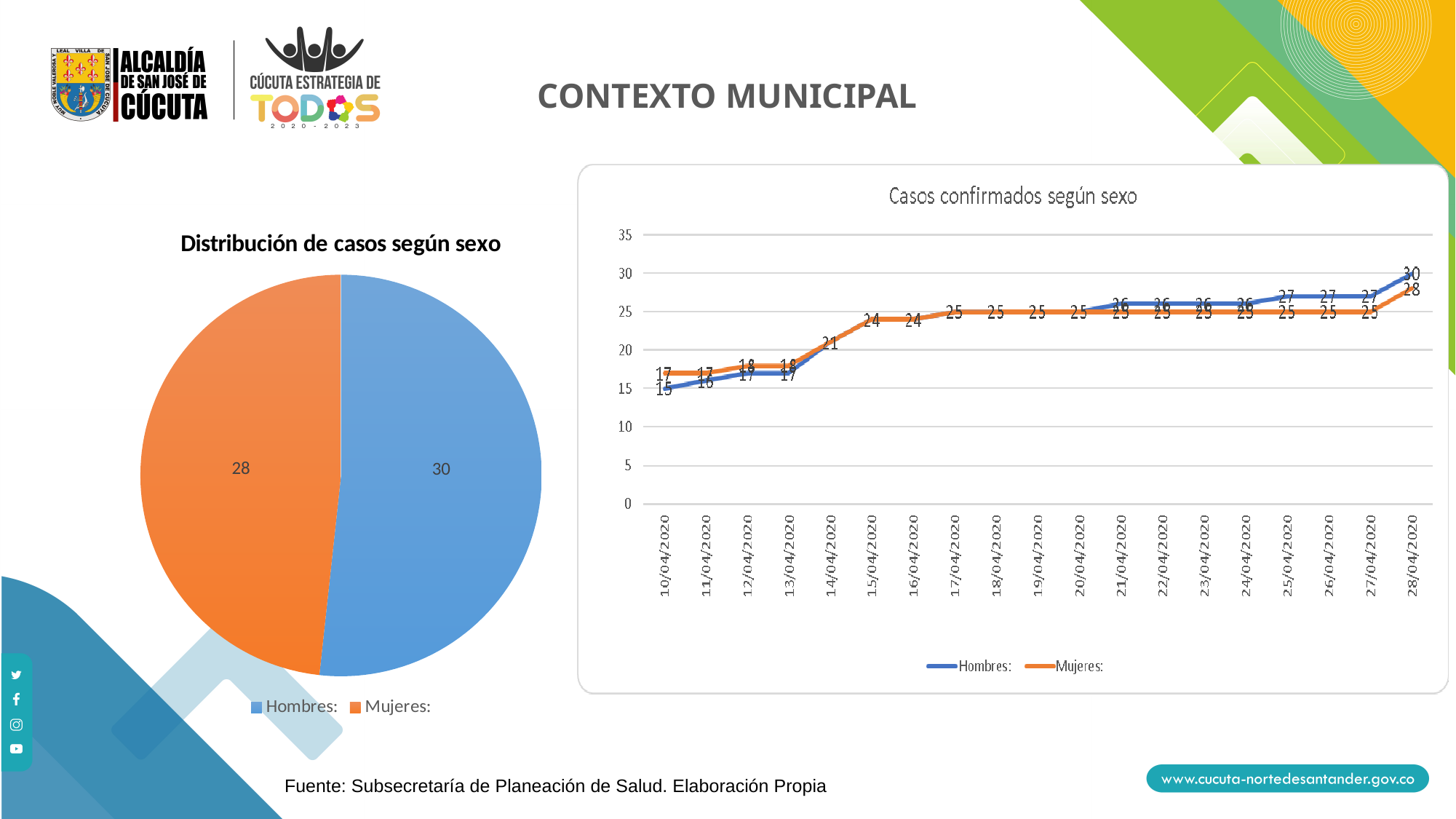
In the chart 'Casos confirmados según sexo', what is the Hombres value on 10/04/2020? 15 In the chart 'Casos confirmados según sexo', what is the Hombres value on 28/04/2020? 30 In the pie chart 'Distribución de casos según sexo', what is the difference between the Hombres and Mujeres values? 2 What kind of chart is 'Casos confirmados según sexo'? Line chart In the chart 'Casos confirmados según sexo', do the Hombres values rise or fall from 10/04/2020 to 28/04/2020? Rise In the chart 'Casos confirmados según sexo', how many series does the legend list? 2 What kind of chart is 'Distribución de casos según sexo'? Pie chart In the pie chart 'Distribución de casos según sexo', what is the value for Hombres? 30 In the pie chart 'Distribución de casos según sexo', what is the value for Mujeres? 28 In the pie chart 'Distribución de casos según sexo', what is the total of the two slices? 58 In the chart 'Casos confirmados según sexo', on 10/04/2020, which series has the larger value, Hombres or Mujeres? Mujeres In the chart 'Casos confirmados según sexo', how many dates are shown on the x axis? 19